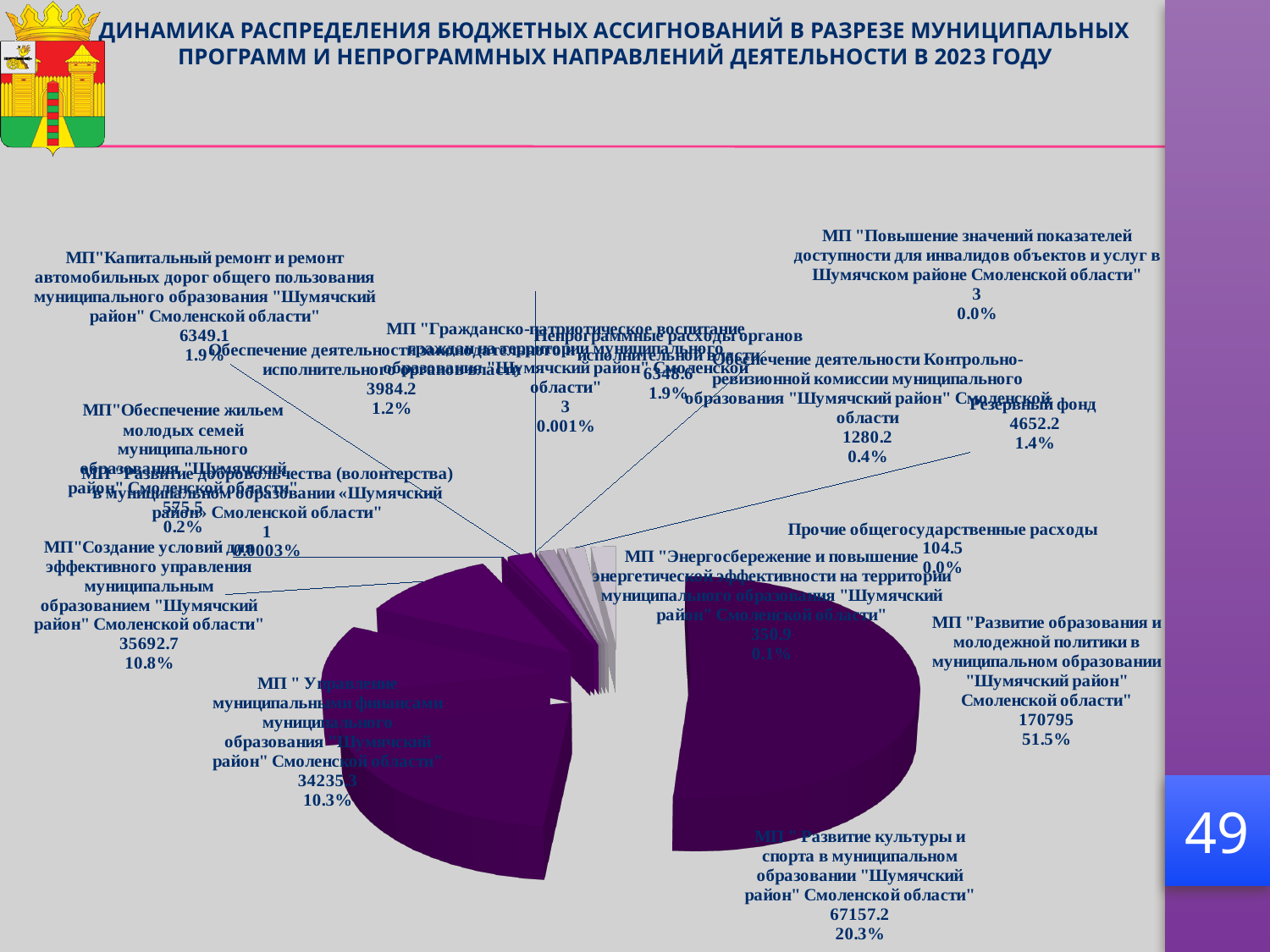
What value is shown for МП "Капитальный ремонт и ремонт автомобильных дорог общего пользования..."? 6349.1 What value is shown for МП "Развитие образования и молодежной политики в муниципальном образовании "Шумячский район" Смоленской области"? 170795 What value is shown for Прочие общегосударственные расходы? 104.5 What year does the chart title say the budget allocation dynamics refer to? 2023 What share of the pie does МП "Развитие культуры и спорта в муниципальном образовании "Шумячский район" Смоленской области" have? 20.3% What percentage is shown for МП "Создание условий для эффективного управления муниципальным образованием "Шумячский район" Смоленской области"? 10.8% Which category has the largest share of the pie? МП "Развитие образования и молодежной политики в муниципальном образовании "Шумячский район" Смоленской области" What value is shown for Резервный фонд? 4652.2 What kind of chart is shown on the slide? pie chart What is the difference between the values for МП "Развитие образования и молодежной политики..." (170795) and МП "Развитие культуры и спорта..." (67157.2)? 103637.8 Which is larger: the value for МП "Создание условий для эффективного управления..." or the value for МП "Управление муниципальными финансами..."? МП "Создание условий для эффективного управления..." What percentage is shown for Обеспечение деятельности Контрольно-ревизионной комиссии муниципального образования "Шумячский район" Смоленской области? 0.4%